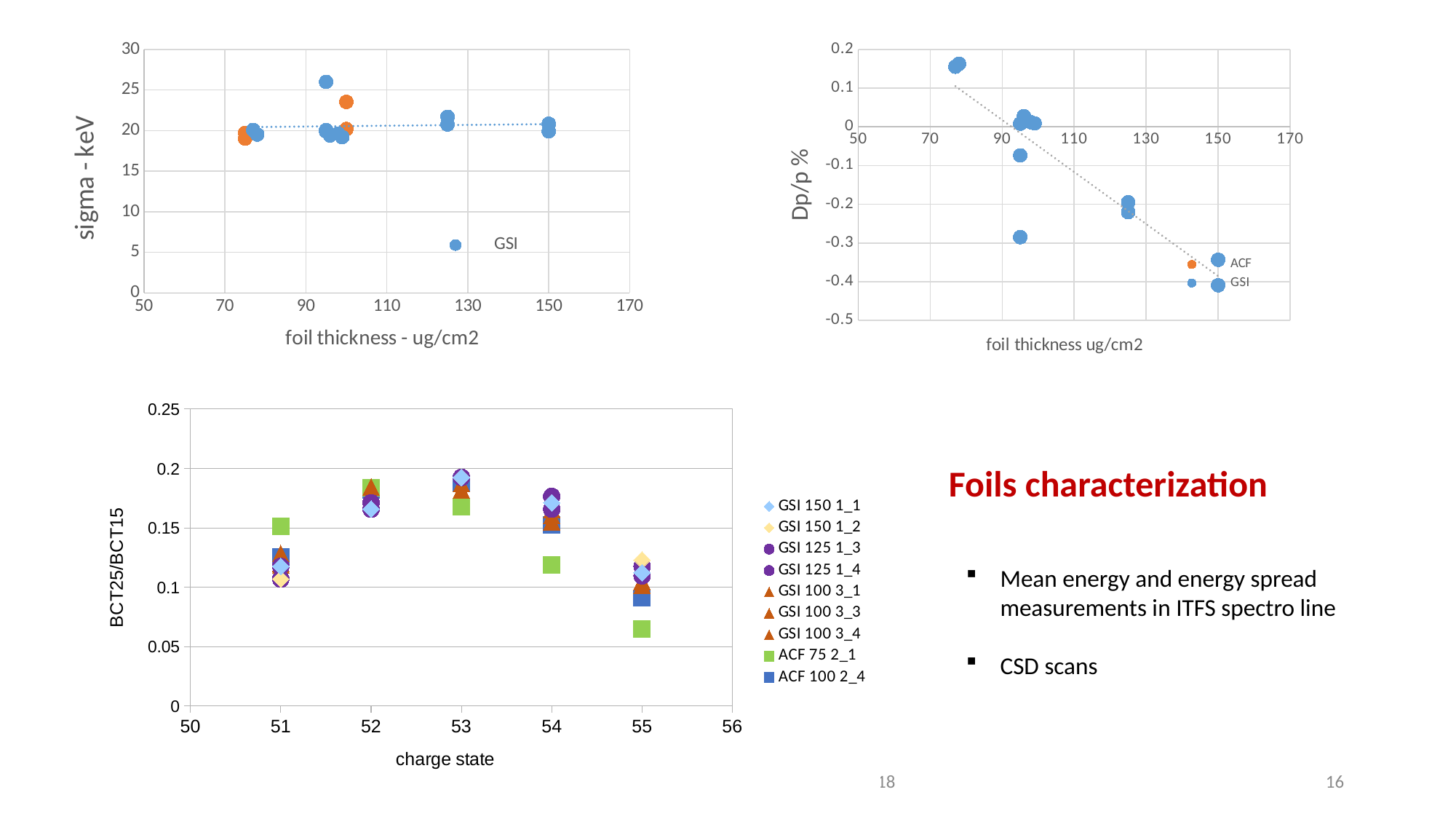
In the bottom-left chart, is the value for ACF 75 2_1 at charge state 54 greater or less than 0.15? less In the top-left chart (sigma - keV vs foil thickness), is the highest sigma value greater or less than 20? greater In the top-right chart (Dp/p % vs foil thickness), what are the two legend entries? ACF and GSI In the bottom-left chart (BCT25/BCT15 vs charge state), how many charge states have data points plotted? 5 What kind of chart is the bottom-left chart (BCT25/BCT15 vs charge state)? scatter chart In the top-left chart (sigma - keV vs foil thickness), is the isolated GSI point near foil thickness 127 greater or less than 10? less In the top-left chart (sigma - keV vs foil thickness), what is the y-axis title? sigma - keV In the top-right chart (Dp/p % vs foil thickness), do the Dp/p values rise or fall as foil thickness increases? fall In the bottom-left chart (BCT25/BCT15 vs charge state), how many series does the legend list? 9